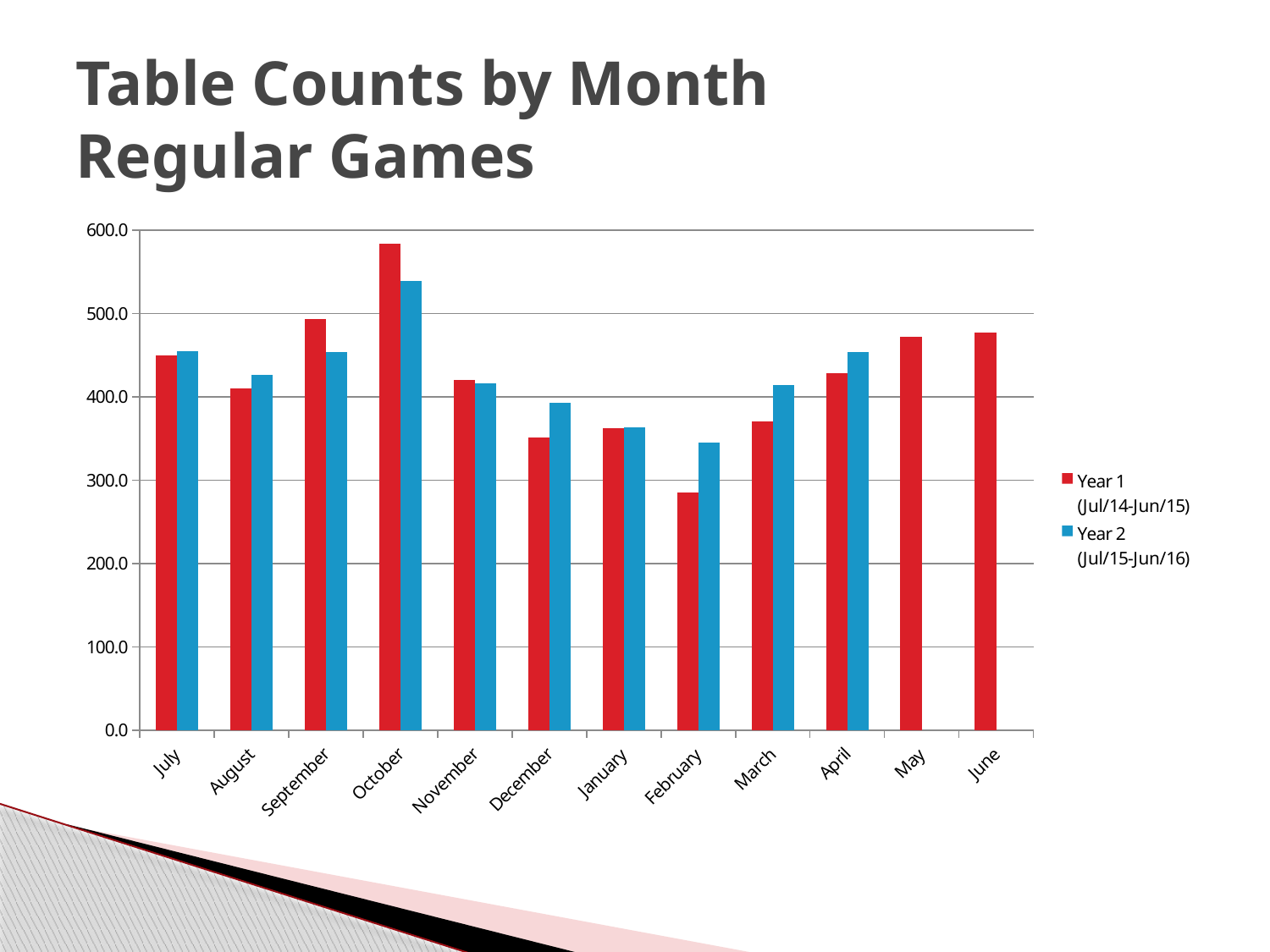
Is the Year 1 (Jul/14-Jun/15) value for October greater or less than 500? greater Which month has the highest Year 2 (Jul/15-Jun/16) table count? October Which month has the highest Year 1 (Jul/14-Jun/15) table count? October In February, which series has the larger value, Year 1 (Jul/14-Jun/15) or Year 2 (Jul/15-Jun/16)? Year 2 (Jul/15-Jun/16) How many series does the chart's legend list? 2 Is the Year 2 (Jul/15-Jun/16) value for March greater or less than 400? greater Which months have no Year 2 (Jul/15-Jun/16) bar in the chart? May and June Which month has the lowest Year 1 (Jul/14-Jun/15) table count? February What kind of chart is shown on the slide? bar chart How many months are shown on the x axis of the chart? 12 In September, which series has the larger value, Year 1 (Jul/14-Jun/15) or Year 2 (Jul/15-Jun/16)? Year 1 (Jul/14-Jun/15) Is the Year 1 (Jul/14-Jun/15) value for February greater or less than 300? less